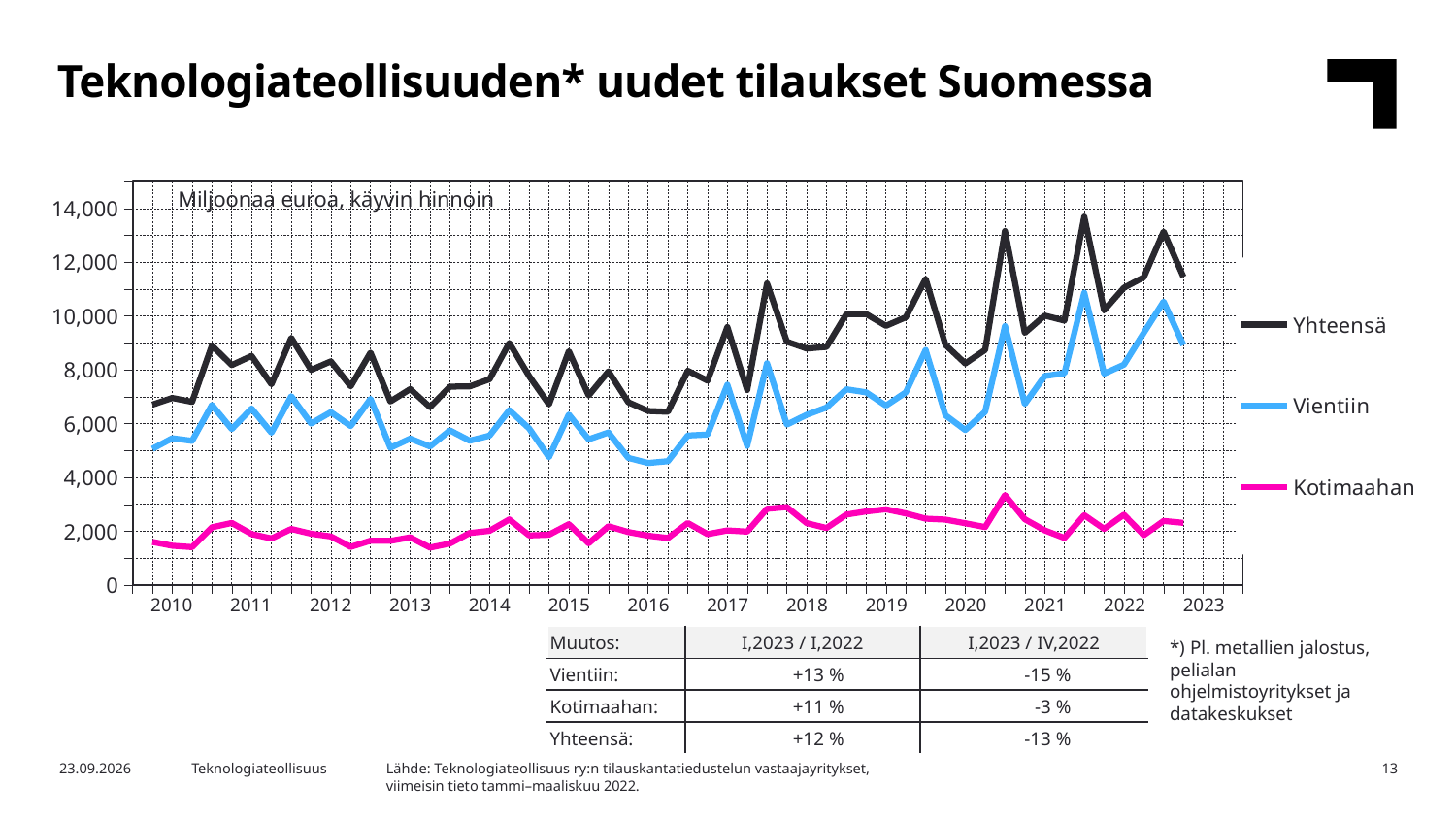
Is the value for Vientiin at the start of 2010 greater or less than 4,000? greater Overall, do the Yhteensä values rise or fall from 2010 to 2023? rise Is the peak value for Yhteensä in 2021 greater or less than 12,000? greater Which series has the lowest values throughout the chart? Kotimaahan What kind of chart is shown on the slide? Line chart Which series has the highest values throughout the chart? Yhteensä What is the title of the chart on the slide? Teknologiateollisuuden* uudet tilaukset Suomessa How many series does the chart legend list? 3 Which is larger in 2020: the value for Vientiin or the value for Kotimaahan? Vientiin Is the value for Kotimaahan at the start of 2010 greater or less than 4,000? less What unit label is shown inside the chart area? Miljoonaa euroa, käyvin hinnoin